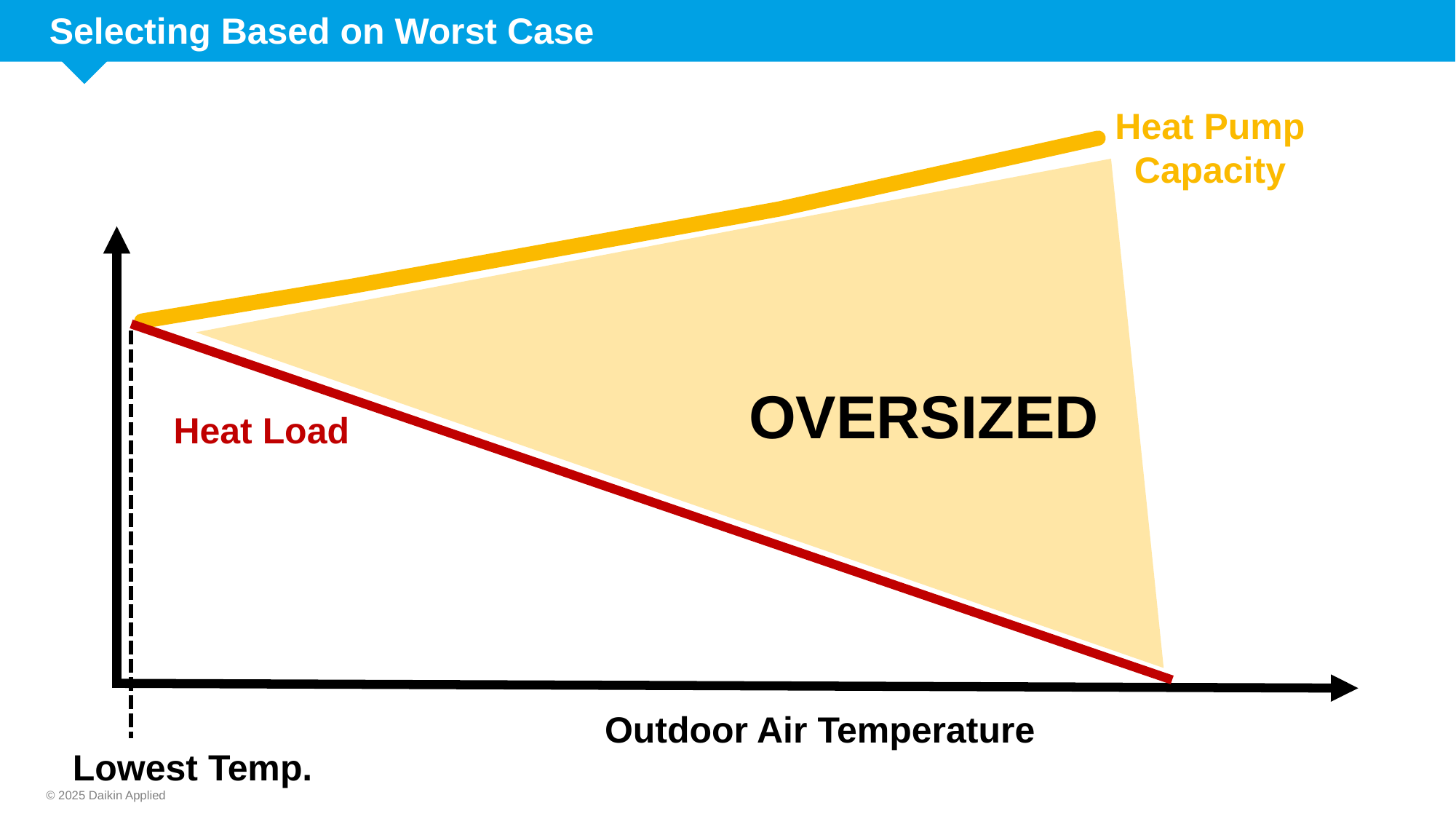
Does the Heat Pump Capacity line rise or fall as Outdoor Air Temperature increases? Rise What is the label on the horizontal axis of the chart? Outdoor Air Temperature What word labels the shaded region between the two lines? OVERSIZED Which line is drawn in red? Heat Load How many lines (series) are plotted on the chart? 2 At the highest Outdoor Air Temperature shown, which is larger, Heat Pump Capacity or Heat Load? Heat Pump Capacity What kind of chart is shown on the slide? Line chart Does the Heat Load line rise or fall as Outdoor Air Temperature increases? Fall